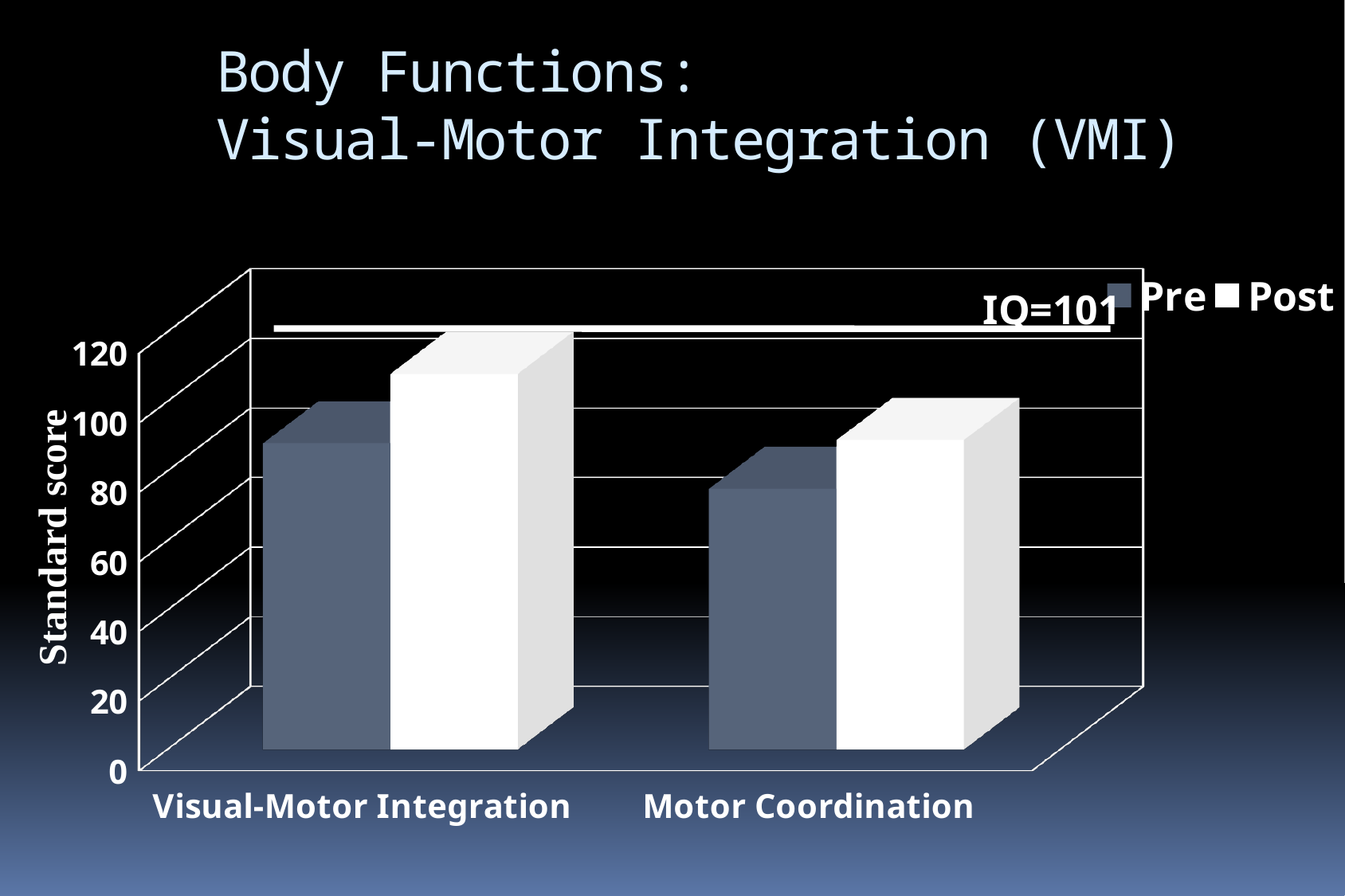
Is the Post value for Visual-Motor Integration greater or less than 100? greater Which bar in the chart is the shortest? Pre for Motor Coordination For Visual-Motor Integration, which is larger, the Pre value or the Post value? Post What kind of chart is shown on the slide? bar chart For Motor Coordination, which is larger, the Pre value or the Post value? Post Which bar in the chart is the tallest? Post for Visual-Motor Integration Is the Post value for Motor Coordination greater or less than 80? greater What is the title of the chart's vertical axis? Standard score What are the two series named in the chart's legend? Pre and Post How many series does the chart's legend list? 2 Is the Pre value for Visual-Motor Integration greater or less than 100? less How many categories are shown on the x axis of the chart? 2